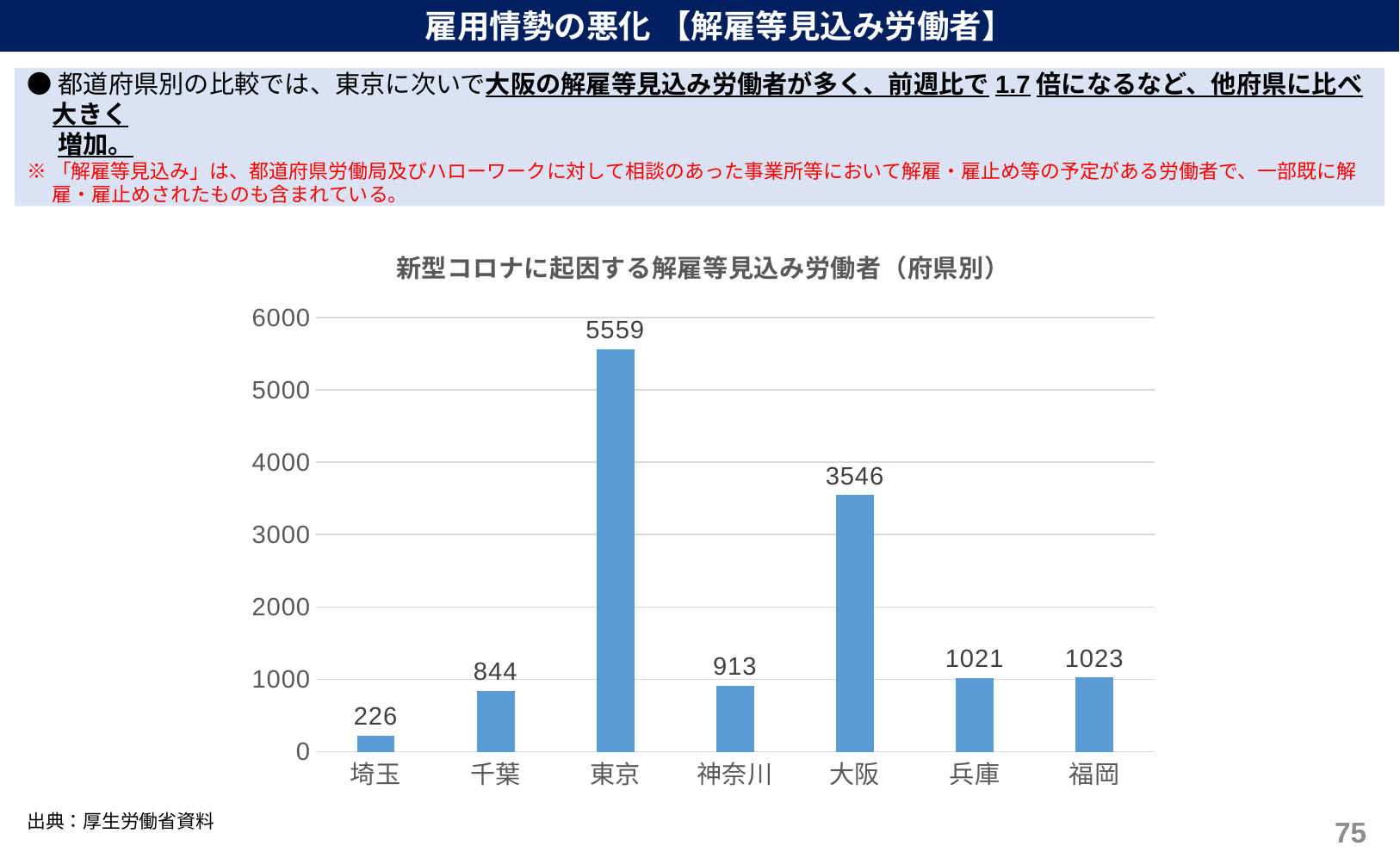
What is the value for 埼玉 in the chart? 226 What is the title of the chart? 新型コロナに起因する解雇等見込み労働者（府県別） What is the difference between the values for 東京 and 大阪? 2013 How many prefectures are shown in the chart? 7 What is the value for 東京 in the chart? 5559 What is the value for 大阪 in the chart? 3546 Which prefecture has the highest value in the chart? 東京 What is the difference between the values for 神奈川 and 千葉? 69 Which prefecture has the lowest value in the chart? 埼玉 Which is larger, the value for 大阪 or the value for 兵庫? 大阪 Is the value for 神奈川 greater or less than 1000? less What kind of chart is shown on the slide? bar chart